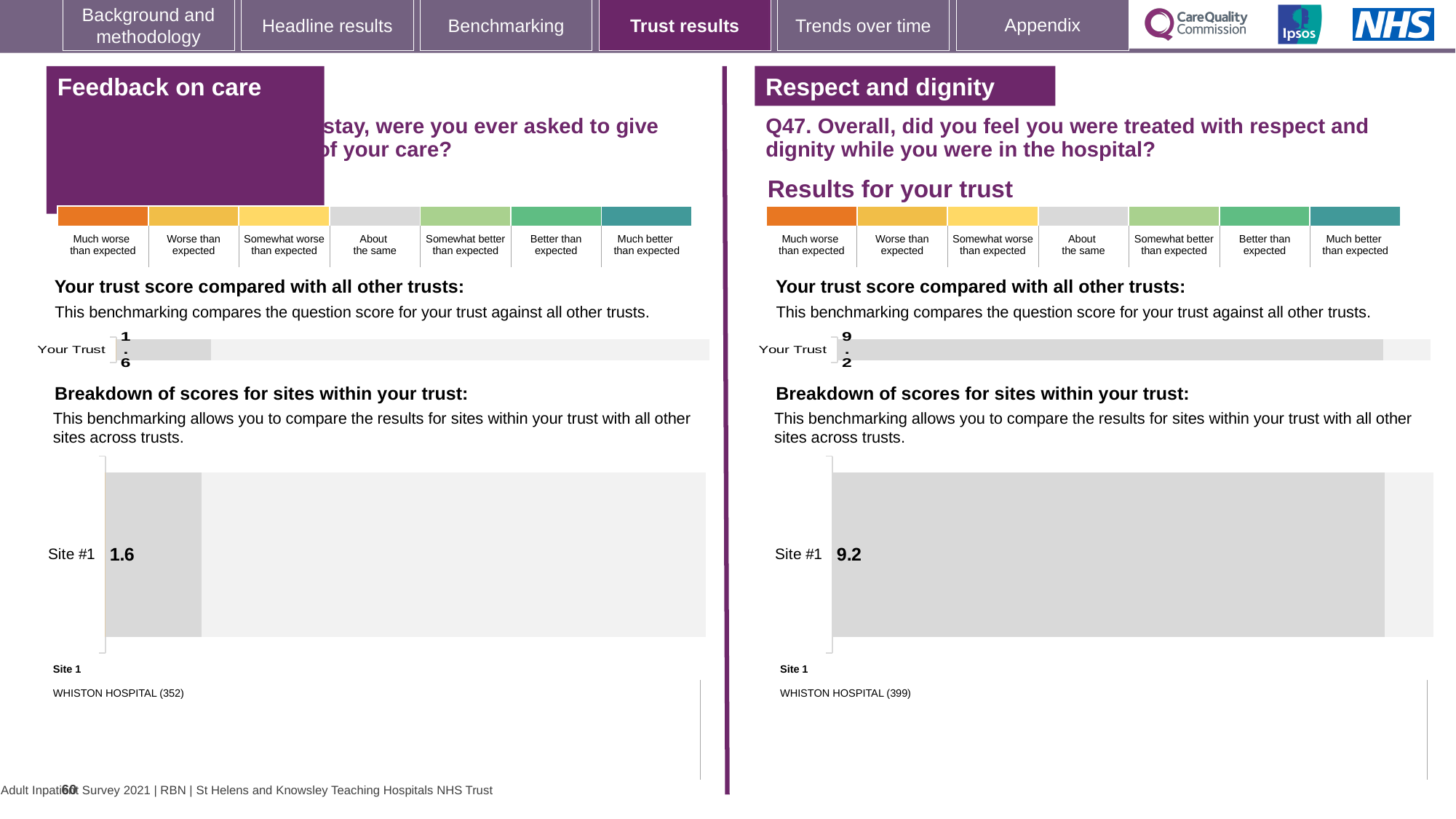
On the Feedback on care panel, what is the score shown for Your Trust in the 'Your trust score compared with all other trusts' chart? 1.6 On the Feedback on care panel, what score is shown for Site #1 in the breakdown of scores for sites chart? 1.6 On the Feedback on care panel, is the Site #1 score greater or less than 5? less What is the difference between the Site #1 score on the Respect and dignity panel and the Site #1 score on the Feedback on care panel? 7.6 Which hospital is listed as Site 1 on the Respect and dignity panel? WHISTON HOSPITAL Which panel shows the higher Site #1 score, Feedback on care or Respect and dignity? Respect and dignity What number appears in parentheses after WHISTON HOSPITAL on the Respect and dignity panel? 399 On the Respect and dignity panel, what score is shown for Site #1 in the breakdown of scores for sites chart? 9.2 What kind of chart is used to show the breakdown of scores for sites on the Feedback on care panel? Bar chart Which panel shows the higher Your Trust score, Feedback on care or Respect and dignity? Respect and dignity On the Respect and dignity panel, what is the score shown for Your Trust in the 'Your trust score compared with all other trusts' chart? 9.2 How many sites are shown in the breakdown of scores for sites chart on the Respect and dignity panel? 1